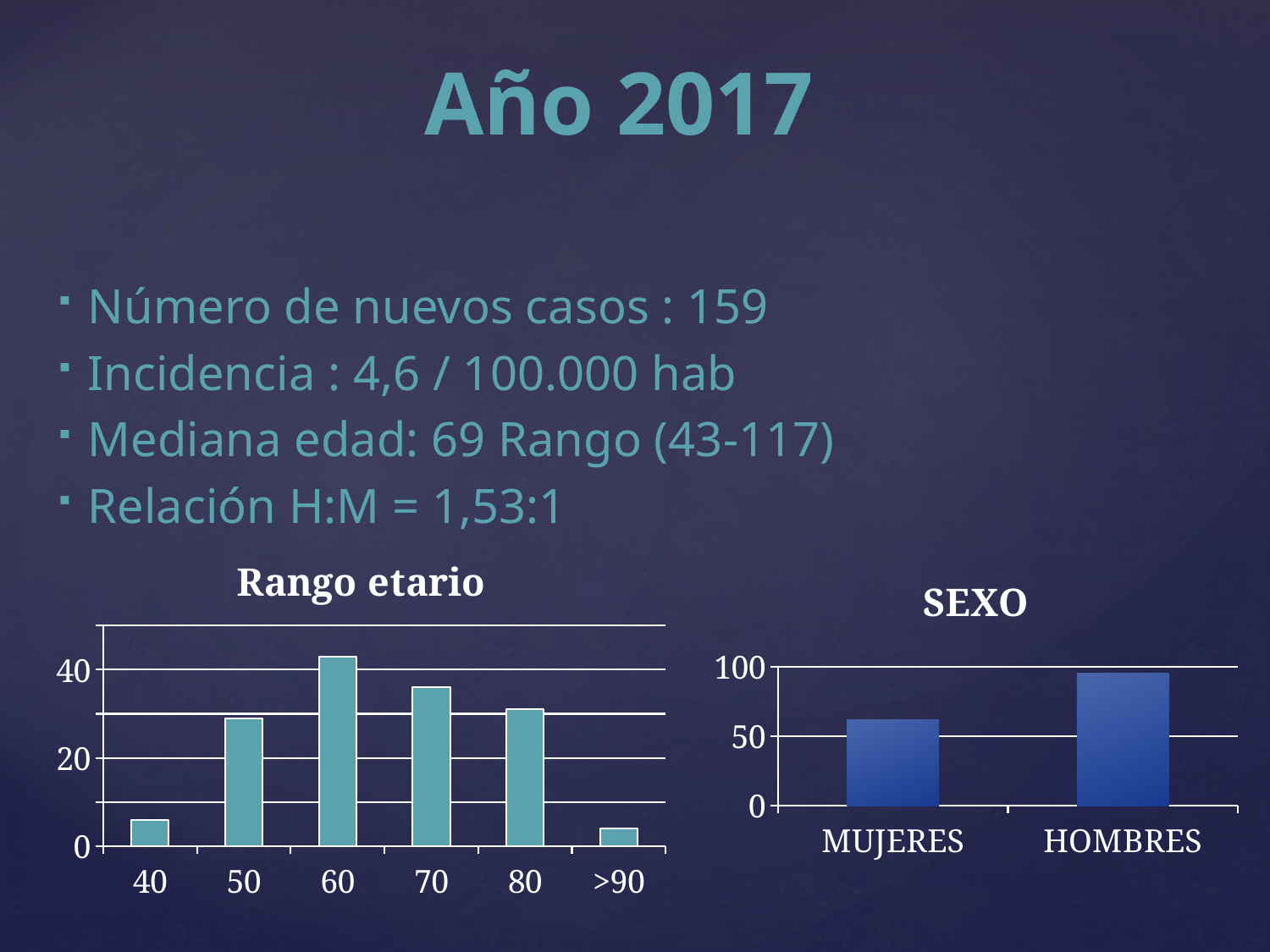
How many categories are shown in the "SEXO" chart? 2 What is the title of the chart on the left of the slide? Rango etario In the "Rango etario" chart, which age category has the lowest bar? >90 What kind of chart is the "Rango etario" chart? bar chart How many age categories are shown on the x axis of the "Rango etario" chart? 6 In the "Rango etario" chart, is the value for 40 greater or less than 20? less In the "SEXO" chart, is the value for MUJERES greater or less than 50? greater What kind of chart is the "SEXO" chart? bar chart In the "Rango etario" chart, is the value for 60 greater or less than 40? greater In the "Rango etario" chart, which age category has the highest bar? 60 In the "Rango etario" chart, which is larger, the value for 50 or the value for 70? 70 In the "SEXO" chart, which category has the higher bar? HOMBRES